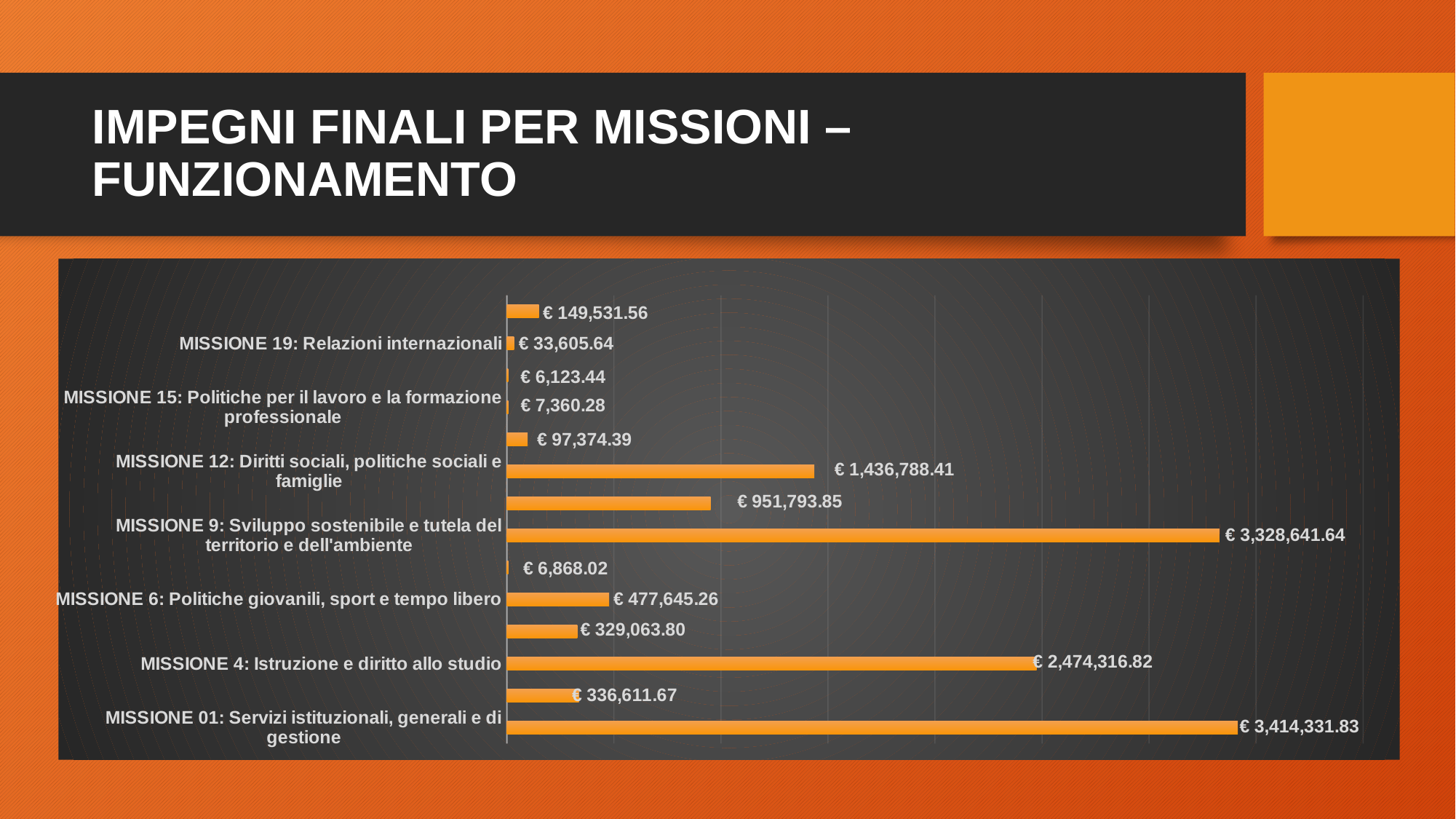
How many bars are plotted in the chart? 14 What is the difference between the values for MISSIONE 4 and MISSIONE 12? € 1,037,528.41 What kind of chart is shown on the slide? Bar chart Which is larger, the value for MISSIONE 4 or the value for MISSIONE 12? MISSIONE 4 What is the difference between the values for MISSIONE 01 and MISSIONE 9? € 85,690.19 What is the value for MISSIONE 19: Relazioni internazionali? € 33,605.64 Which is larger, the value for MISSIONE 6 or the value for MISSIONE 19? MISSIONE 6 What is the value for MISSIONE 01: Servizi istituzionali, generali e di gestione? € 3,414,331.83 What is the value for MISSIONE 15: Politiche per il lavoro e la formazione professionale? € 7,360.28 What is the value for MISSIONE 9: Sviluppo sostenibile e tutela del territorio e dell'ambiente? € 3,328,641.64 Which mission has the highest value? MISSIONE 01: Servizi istituzionali, generali e di gestione What is the value for MISSIONE 4: Istruzione e diritto allo studio? € 2,474,316.82